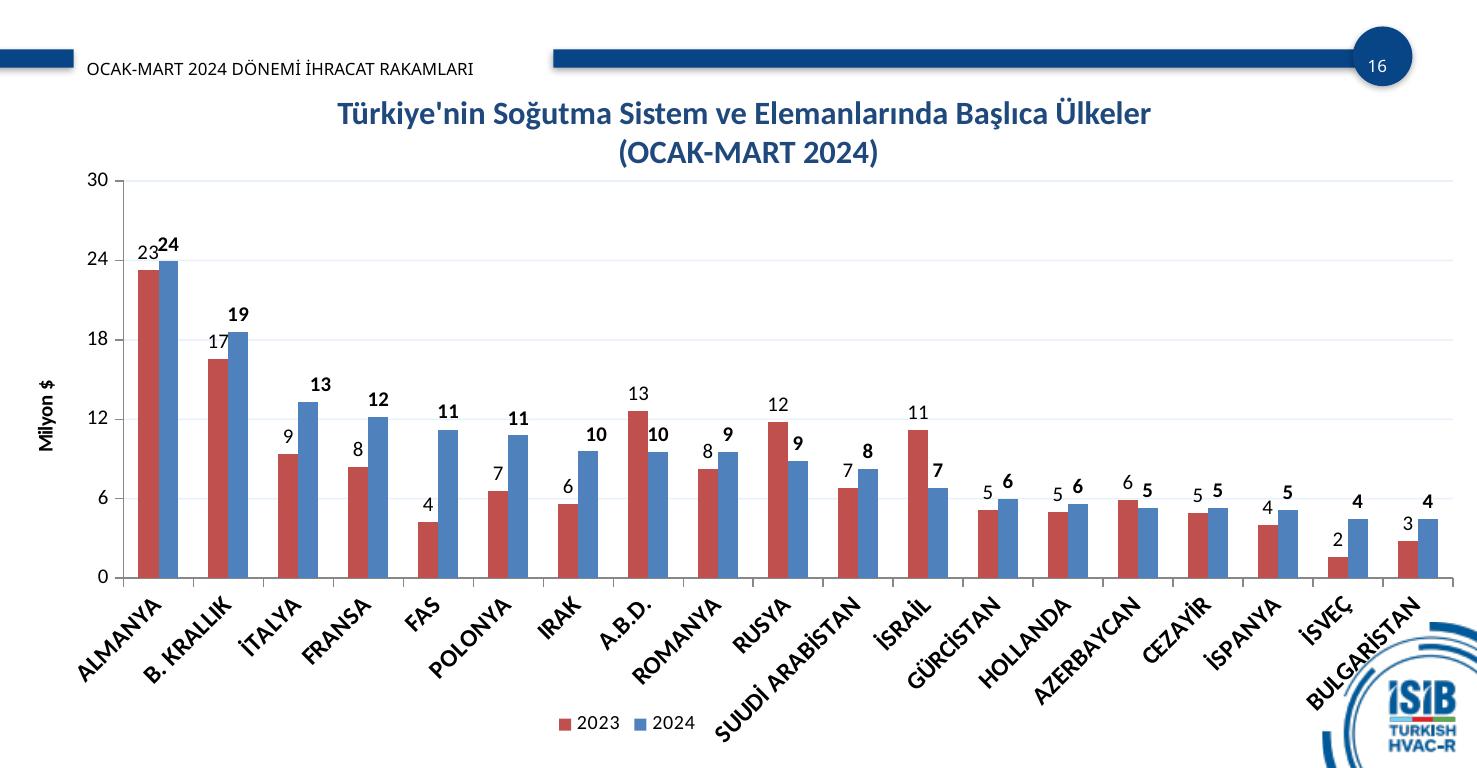
What kind of chart is shown on the slide? Bar chart How many countries are shown on the x axis? 19 What is the 2023 value for A.B.D.? 13 What is the 2024 value for ALMANYA? 24 Which country has the lowest 2023 value? İSVEÇ How many series does the legend list? 2 What is the label of the y axis? Milyon $ What is the difference between the 2024 and 2023 values for FAS? 7 Which is larger for İSRAİL, the 2023 value or the 2024 value? 2023 What is the 2023 value for FAS? 4 Which country has the highest 2024 value? ALMANYA What is the 2024 value for B. KRALLIK? 19